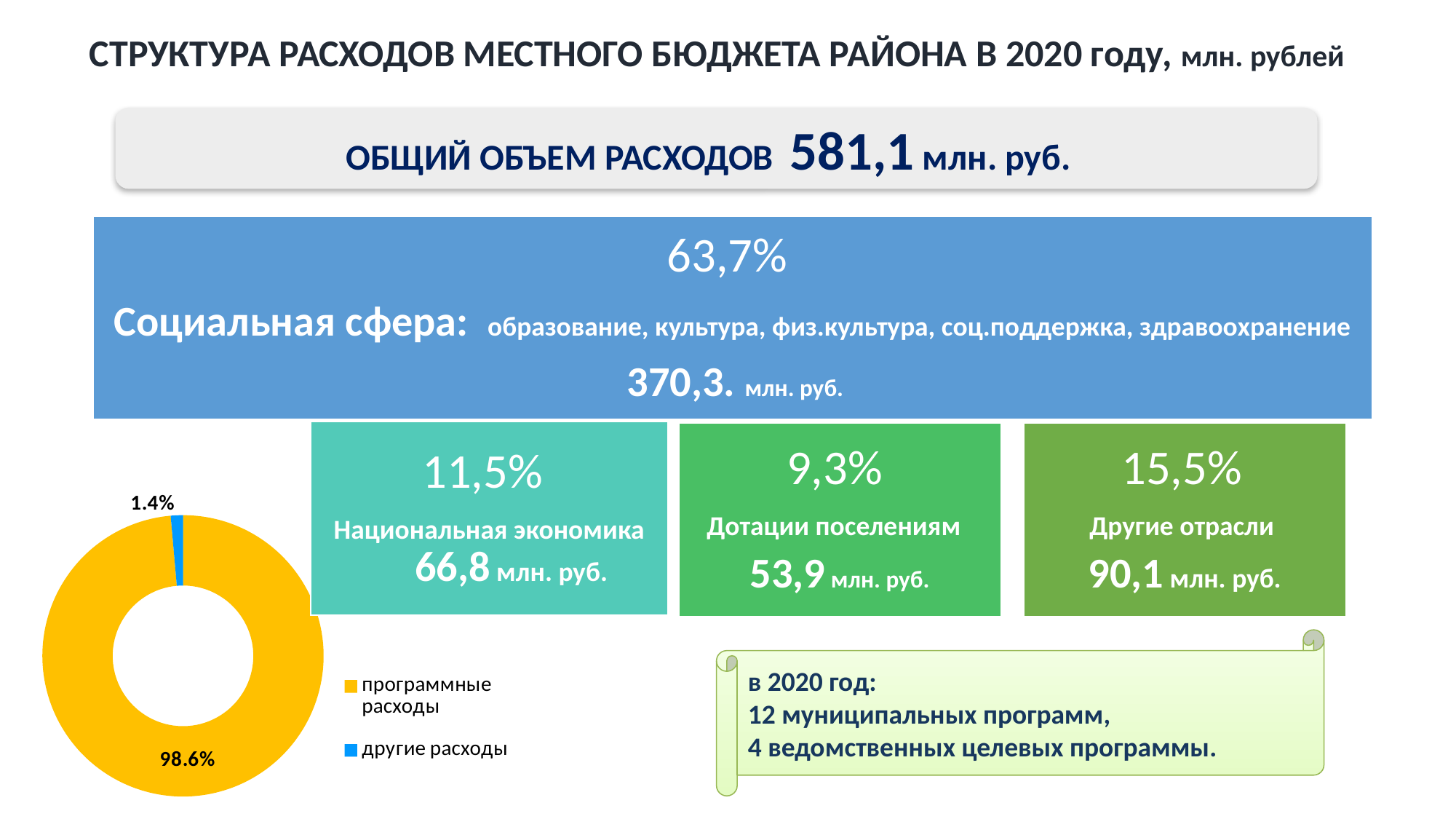
How many entries does the legend of the doughnut chart list? 2 What share of the doughnut chart is labelled "другие расходы"? 1.4% What is the difference in percentage points between the shares of "программные расходы" and "другие расходы" in the doughnut chart? 97.2 What colour is the "программные расходы" slice in the doughnut chart? yellow How many categories does the doughnut chart show? 2 Which category in the doughnut chart has the largest share? программные расходы What share of the doughnut chart is labelled "программные расходы"? 98.6% What colour is the "другие расходы" slice in the doughnut chart? blue What kind of chart is shown on the slide? doughnut (pie) chart Which is larger in the doughnut chart: the share of "программные расходы" or the share of "другие расходы"? программные расходы Which category in the doughnut chart has the smallest share? другие расходы